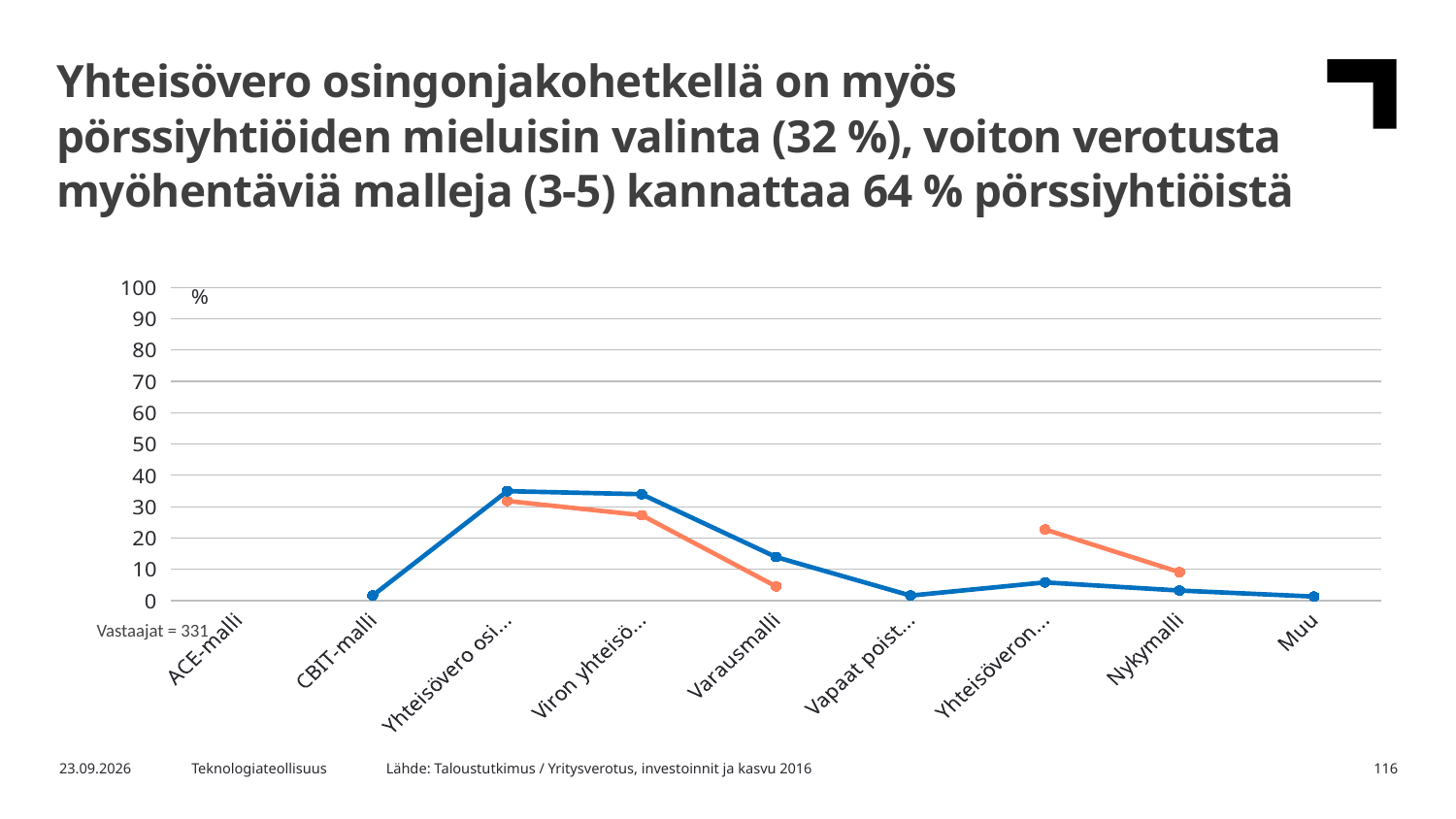
For Varausmalli, which line has the higher value, the blue or the orange? blue Is the value of the blue line for Yhteisövero osi... greater or less than 30? greater What unit is shown at the top of the y axis? % Is the value of the blue line for Vapaat poist... greater or less than 10? less What kind of chart is shown on the slide? line chart How many lines are plotted on the chart? 2 Is the value of the orange line for Varausmalli greater or less than 10? less How many categories are shown on the x axis of the chart? 9 At which category does the orange line reach its highest value? Yhteisövero osi... Does the blue line rise or fall from Viron yhteisö... to Vapaat poist...? fall